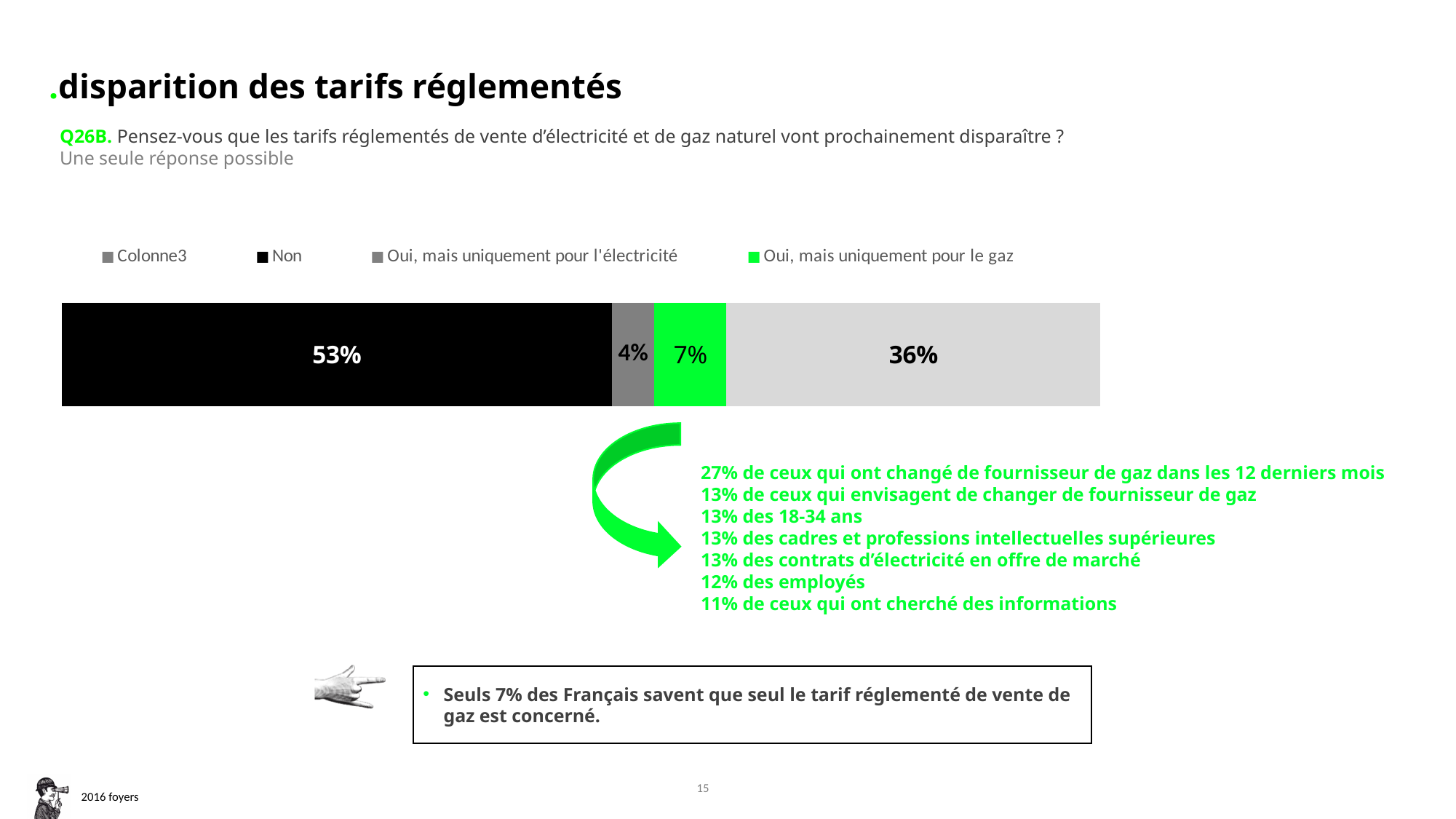
Which legend category has the largest segment in the bar? Non What is the value of the "Oui, mais uniquement pour l'électricité" segment? 4% What colour is the "Oui, mais uniquement pour le gaz" segment? Green What kind of chart is shown on the slide? Stacked bar chart What is the total of all the segments in the stacked bar? 100% Which is larger: "Oui, mais uniquement pour le gaz" or "Oui, mais uniquement pour l'électricité"? Oui, mais uniquement pour le gaz What percentage of respondents answered "Non"? 53% How many series does the legend list? 4 Which legend category has the smallest segment in the bar? Oui, mais uniquement pour l'électricité What is the value of the "Oui, mais uniquement pour le gaz" segment? 7%